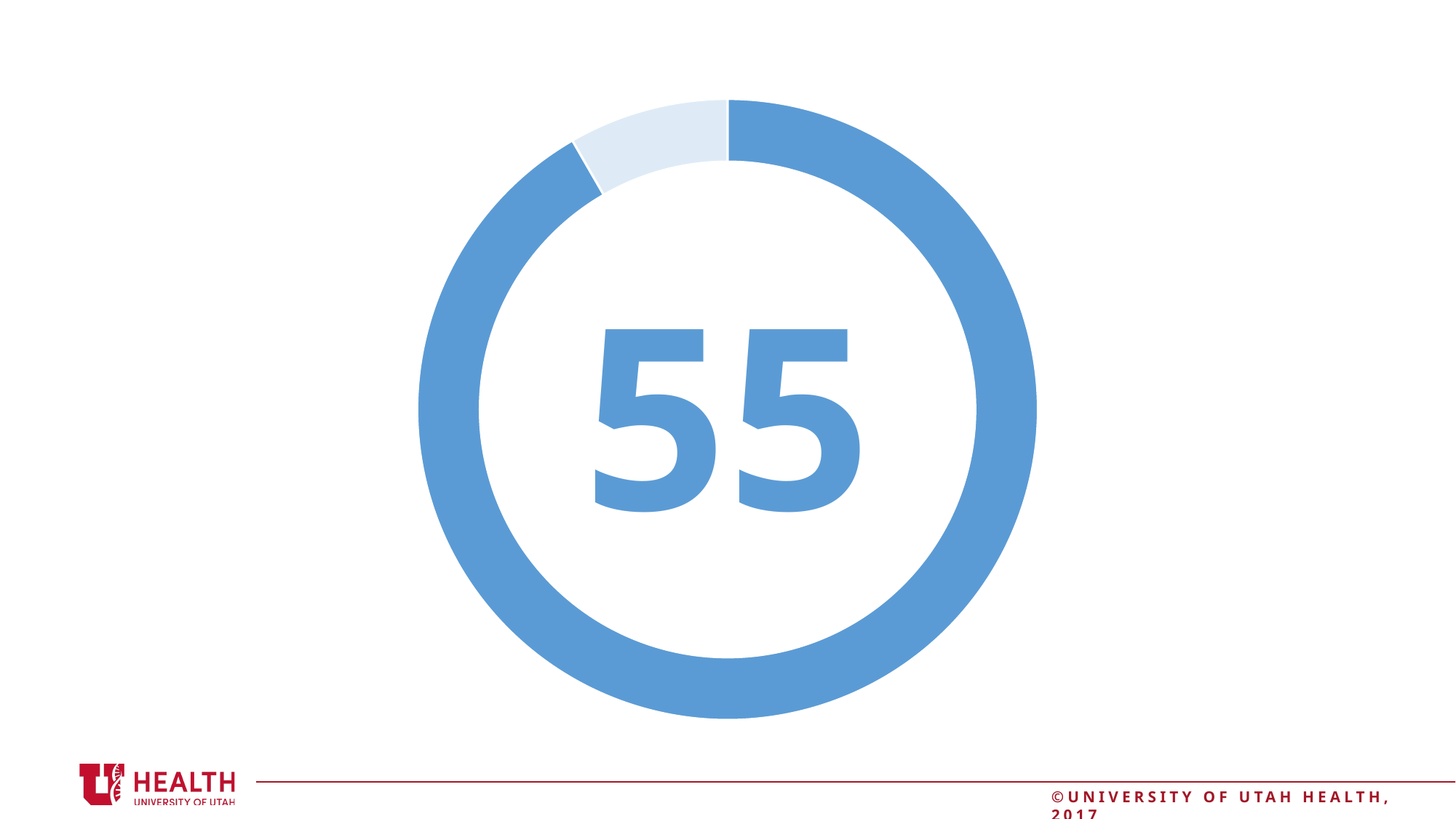
Which segment of the doughnut is larger, the dark blue one or the light blue one? The dark blue one What colour is the largest segment of the doughnut ring? Blue Which segment of the doughnut is the smallest? The light blue segment Does the doughnut chart have a legend? No What number is printed in the centre of the doughnut chart? 55 What kind of chart is shown on the slide? Doughnut chart How many segments does the doughnut ring have? 2